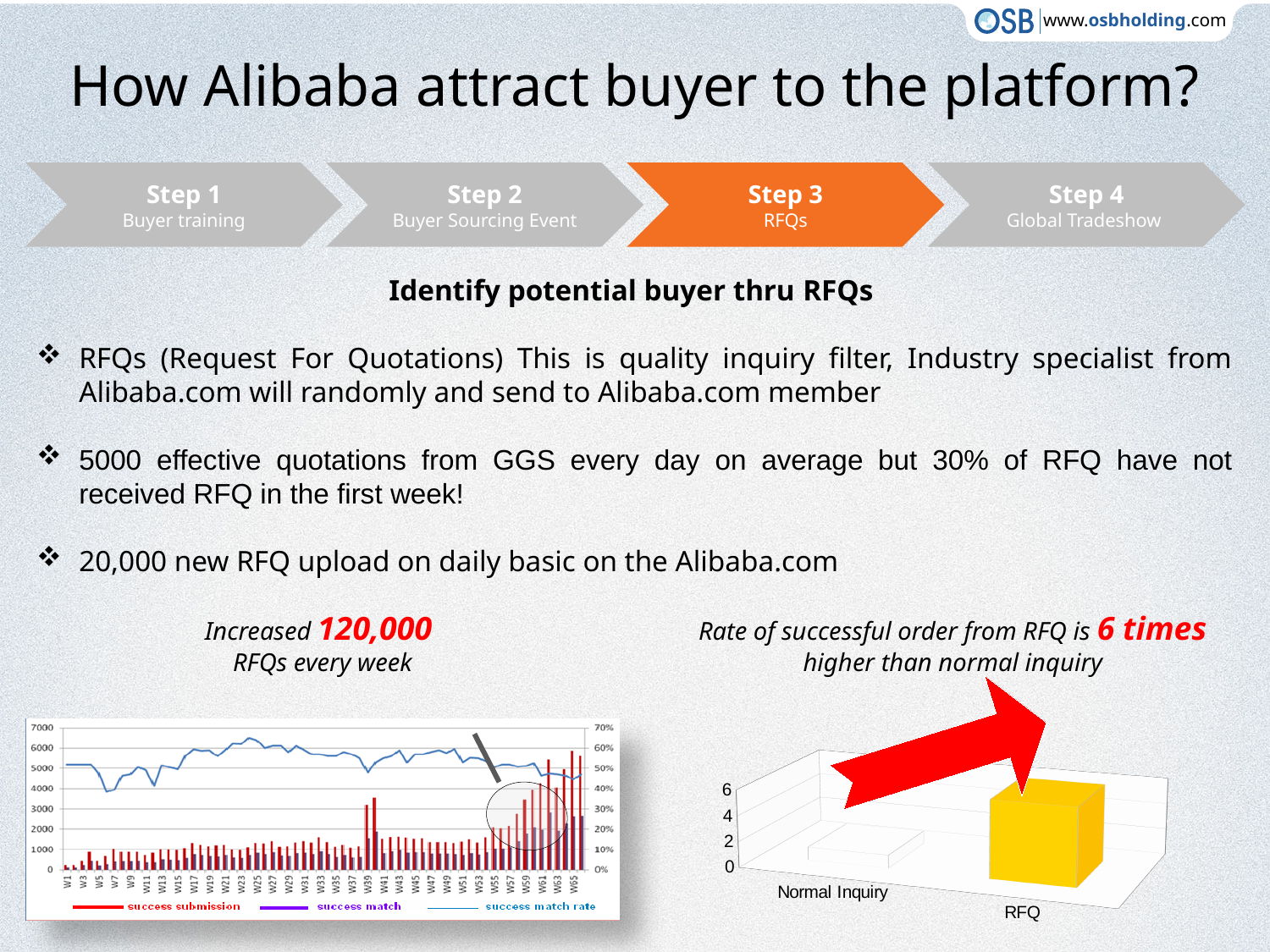
In the chart on the right of the slide, which category has the lowest bar? Normal Inquiry In the chart on the left of the slide, do the success submission bars generally rise or fall toward the last weeks (W55 to W65)? rise What kind of chart is the chart on the right of the slide (Normal Inquiry vs RFQ)? bar chart In the chart on the right of the slide, what is the highest value shown on the vertical axis? 6 In the chart on the left of the slide, how many series does the legend list? 3 In the chart on the right of the slide, is the value for Normal Inquiry greater or less than 2? less In the chart on the left of the slide, is the success submission value at W1 greater or less than 1000? less In the chart on the right of the slide, how many categories are shown on the x axis? 2 In the chart on the right of the slide, is the value for RFQ greater or less than 4? greater In the chart on the left of the slide, which series is drawn in red in the legend? success submission In the chart on the right of the slide, which category has the higher bar, Normal Inquiry or RFQ? RFQ